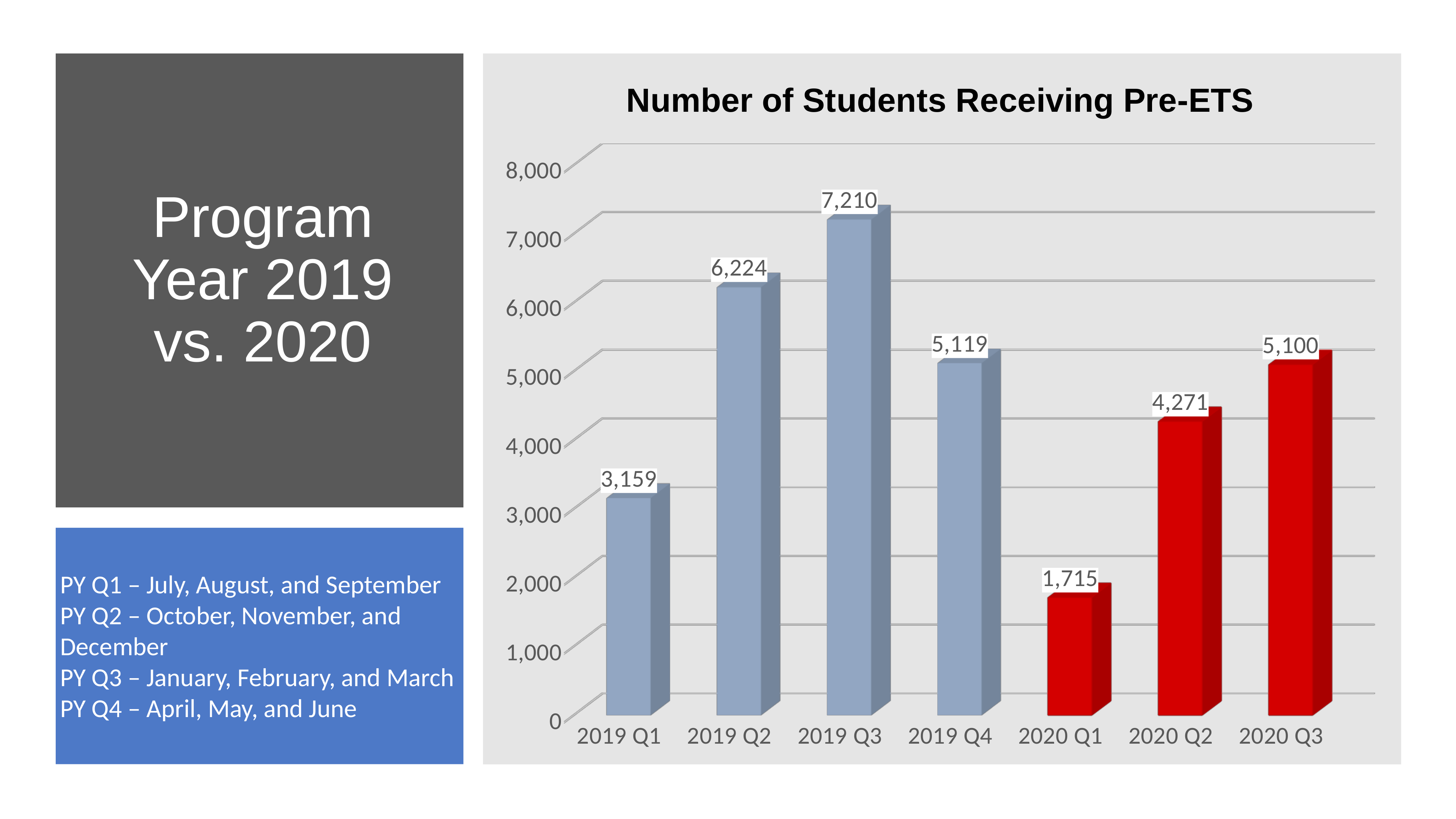
What is the difference between the number of students in 2019 Q2 and 2020 Q2? 1,953 Which quarter has the lowest number of students receiving Pre-ETS? 2020 Q1 What is the title of the chart? Number of Students Receiving Pre-ETS Which quarter has the highest number of students receiving Pre-ETS? 2019 Q3 Is the value for 2020 Q3 greater or less than 4,000? greater How many quarters are shown on the x axis of the chart? 7 What is the number of students receiving Pre-ETS in 2020 Q1? 1,715 What is the difference between the number of students in 2019 Q4 and 2020 Q3? 19 What is the number of students receiving Pre-ETS in 2019 Q1? 3,159 Which is larger, the value for 2019 Q1 or the value for 2020 Q2? 2020 Q2 What kind of chart is shown on the slide? bar chart What is the number of students receiving Pre-ETS in 2019 Q3? 7,210